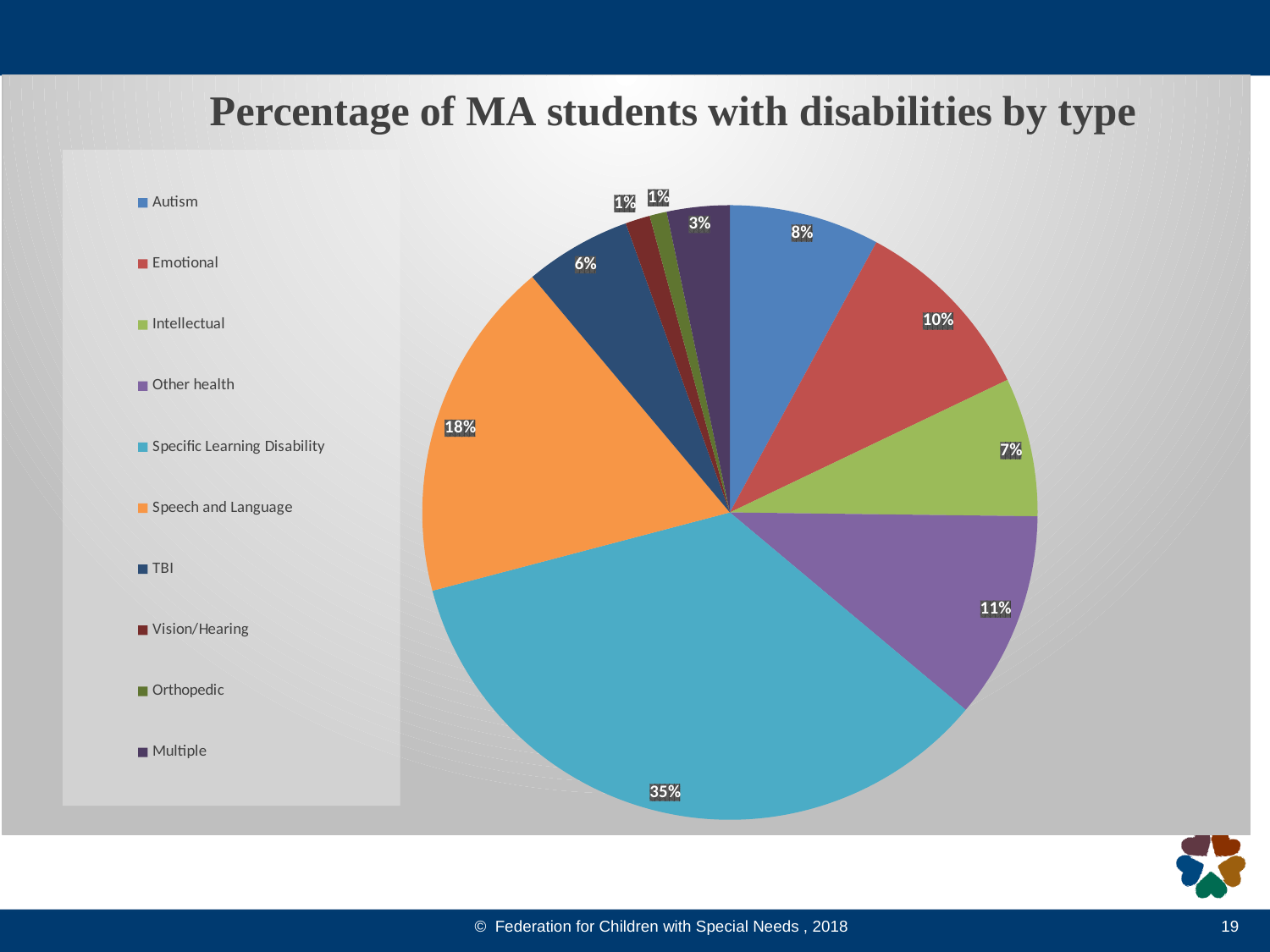
Which disability type has the largest share of the pie? Specific Learning Disability Which is larger, the share for Emotional or the share for Intellectual? Emotional What percentage is shown for Other health? 11% What type of chart is shown on the slide? pie chart What percentage of MA students with disabilities have a Specific Learning Disability? 35% What percentage is shown for Speech and Language? 18% What is the difference between the Specific Learning Disability share and the Speech and Language share? 17% What is the combined share of Autism and Emotional? 18% What percentage is shown for TBI? 6% What percentage is shown for Autism? 8% How many disability types are listed in the legend? 10 What is the title of the chart? Percentage of MA students with disabilities by type